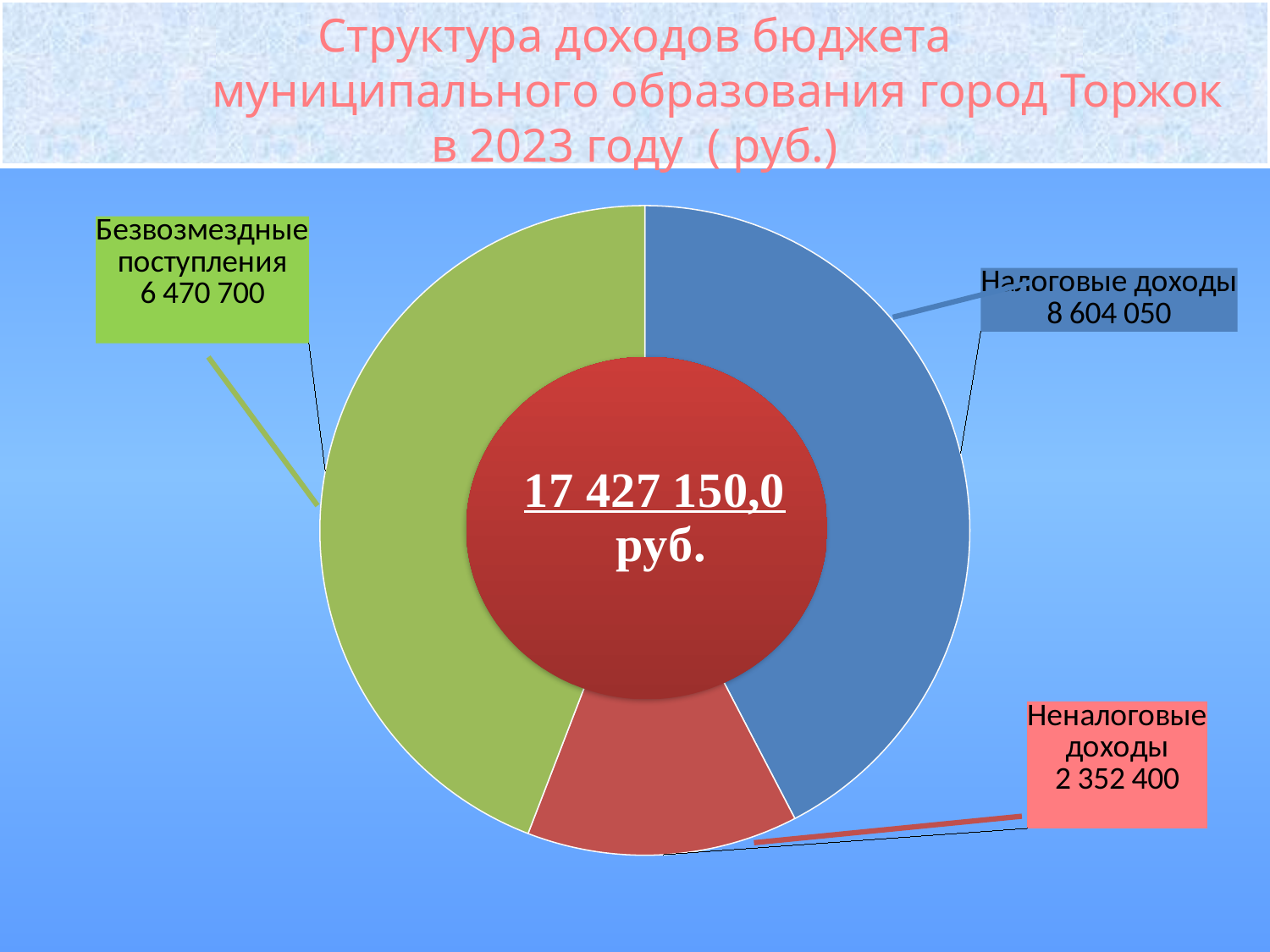
Which category has the smallest value? Неналоговые доходы What kind of chart is shown on the slide? Doughnut chart What total is shown in the centre of the chart? 17 427 150,0 руб. What is the difference between Налоговые доходы and Безвозмездные поступления? 2 133 350 What colour is the slice for Безвозмездные поступления? Green What is the value for Безвозмездные поступления? 6 470 700 Which category has the largest value? Налоговые доходы What is the difference between Безвозмездные поступления and Неналоговые доходы? 4 118 300 How many categories does the chart show? 3 Which is larger, Безвозмездные поступления or Неналоговые доходы? Безвозмездные поступления What is the value for Налоговые доходы? 8 604 050 What is the value for Неналоговые доходы? 2 352 400